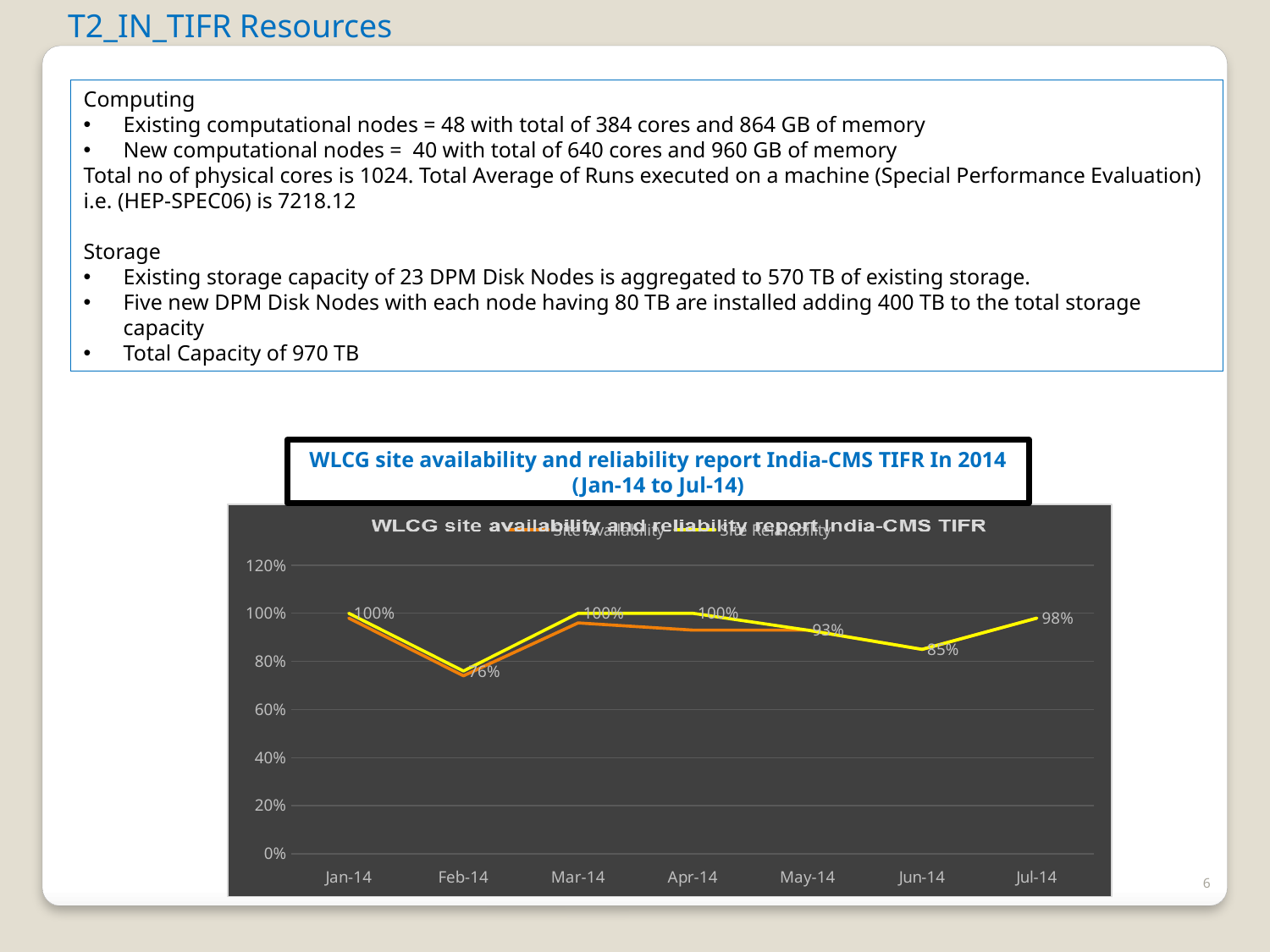
What value is labelled at Jul-14 on the chart? 98% What is the difference between the labelled values for Jan-14 and Feb-14? 24 percentage points Which month has the lowest labelled value on the chart? Feb-14 How many months are plotted along the x axis of the chart? 7 Which is higher, the labelled value for Jul-14 or for Jun-14? Jul-14 What value is labelled at Jun-14 on the chart? 85% What value is labelled at Feb-14 on the chart? 76% What are the two series named in the chart's legend? Site Availability and Site Relaiability What value is labelled at May-14 on the chart? 93% What kind of chart is shown on the slide? line chart How many series does the chart's legend list? 2 Is the labelled value for Feb-14 greater or less than 80%? less